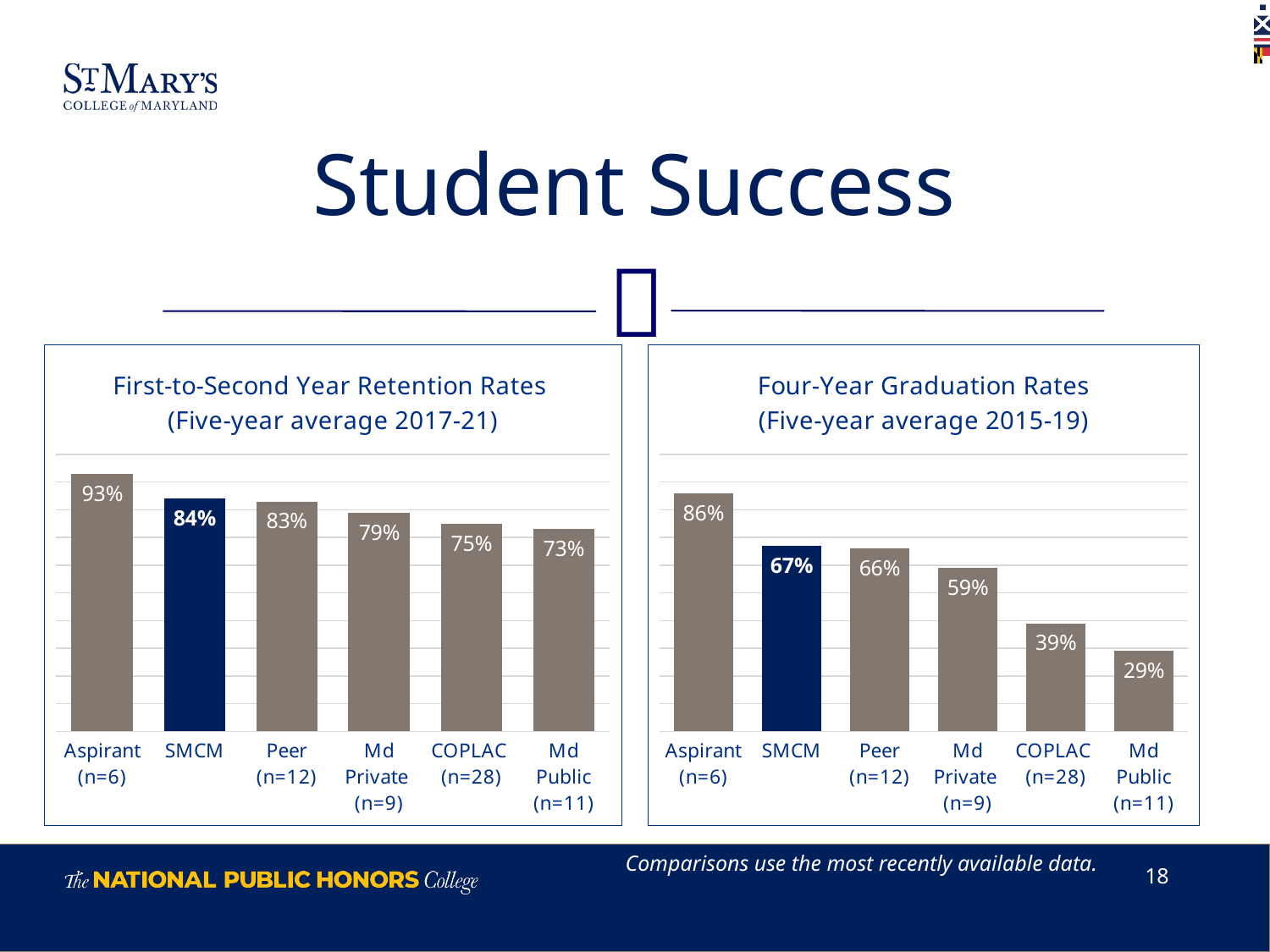
In the First-to-Second Year Retention Rates chart, which bar is coloured dark blue rather than grey? SMCM What kind of chart is the First-to-Second Year Retention Rates chart? Bar chart In the Four-Year Graduation Rates chart, what is the difference between the SMCM value and the COPLAC (n=28) value? 28% In the First-to-Second Year Retention Rates chart, what is the value for SMCM? 84% In the First-to-Second Year Retention Rates chart, what is the difference between the Aspirant (n=6) value and the SMCM value? 9% In the Four-Year Graduation Rates chart, which is larger, the value for Peer (n=12) or the value for Md Private (n=9)? Peer (n=12) In the Four-Year Graduation Rates chart, do the values rise or fall from left to right across the categories? Fall In the Four-Year Graduation Rates chart, which category has the lowest value? Md Public (n=11) How many categories are shown in the Four-Year Graduation Rates chart? 6 In the Four-Year Graduation Rates chart, what is the value for Md Private (n=9)? 59% In the First-to-Second Year Retention Rates chart, which is larger, the value for COPLAC (n=28) or the value for Md Public (n=11)? COPLAC (n=28) In the First-to-Second Year Retention Rates chart, which category has the highest value? Aspirant (n=6)